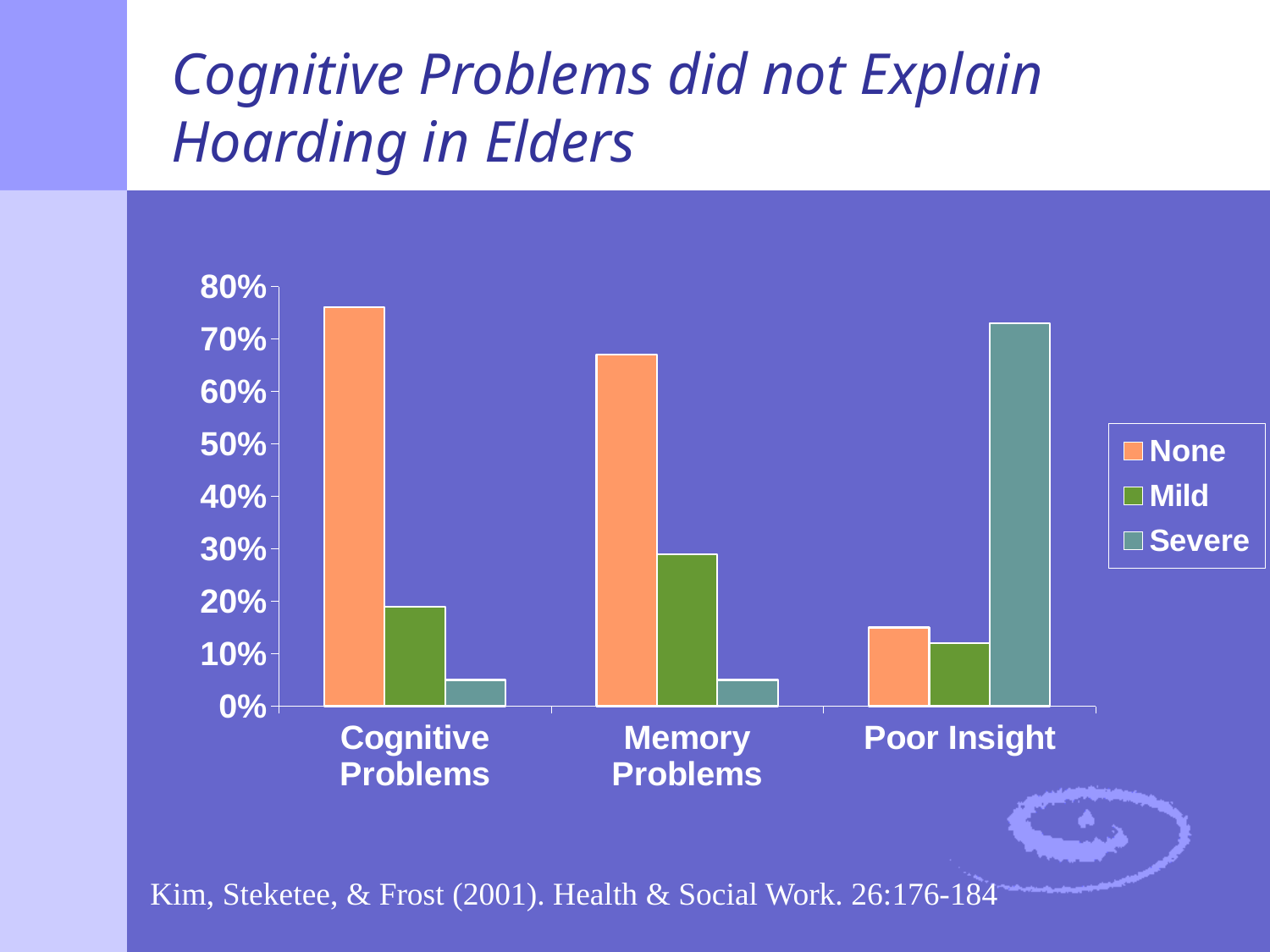
Is the value for Severe in Cognitive Problems greater or less than 10%? less How many categories are shown on the x axis? 3 Which series has the highest value for Cognitive Problems? None Which series has the highest value for Poor Insight? Severe Which is larger, the None value for Cognitive Problems or the None value for Memory Problems? Cognitive Problems Which series is shown in orange in the legend? None What kind of chart is shown on the slide? bar chart Is the value for None in Cognitive Problems greater or less than 70%? greater Is the value for Severe in Poor Insight greater or less than 70%? greater Which series has the lowest value for Memory Problems? Severe How many series does the legend list? 3